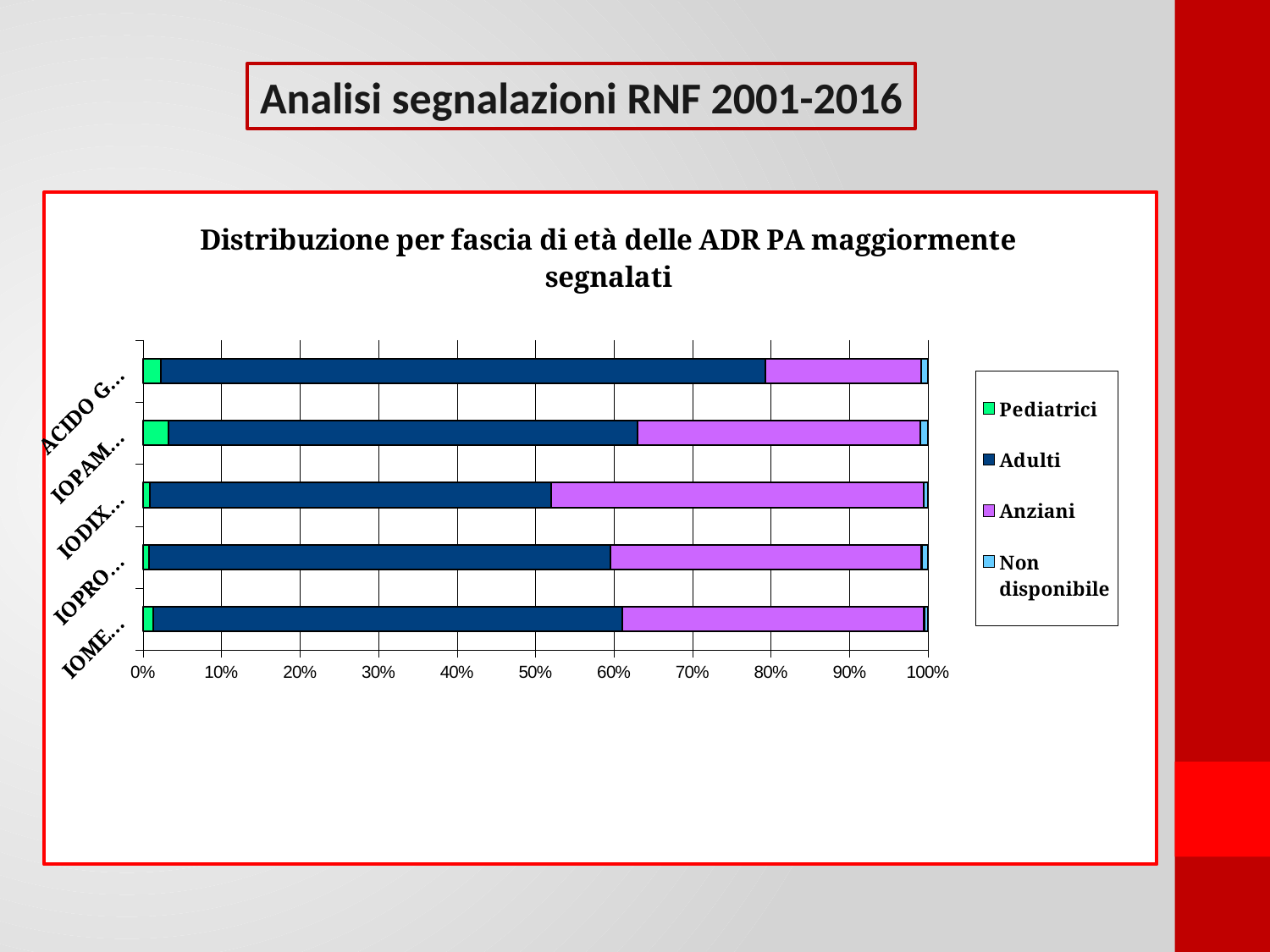
How many bars (categories) are plotted in the chart? 5 What kind of chart is shown on the slide? Stacked bar chart Which category has the largest Anziani share? IODIX... Is the Adulti share for the top bar (ACIDO G...) greater or less than 70%? greater How many series does the legend list? 4 Is the Adulti share for the middle bar (IODIX...) greater or less than 60%? less Which category has the largest Adulti share? ACIDO G... Which category has the smallest Adulti share? IODIX... What is the title of the chart? Distribuzione per fascia di età delle ADR PA maggiormente segnalati Which has a larger Adulti share, the top bar (ACIDO G...) or the middle bar (IODIX...)? ACIDO G... Is the Adulti share for the second bar (IOPAM...) greater or less than 70%? less Which legend entry is shown in dark blue? Adulti